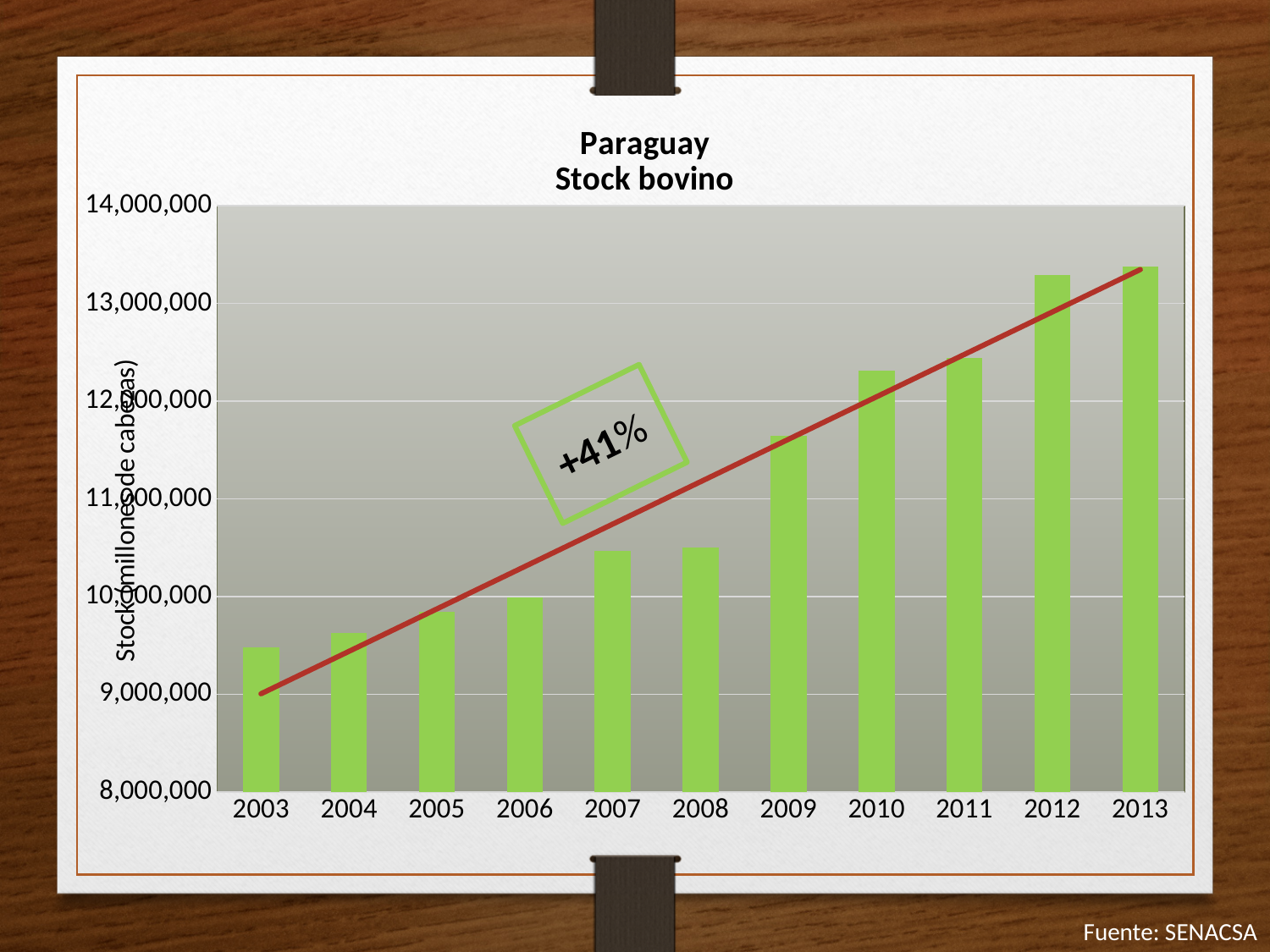
What kind of chart is shown on the slide? bar chart Is the value for 2012 greater or less than 13,000,000? greater Is the value for 2003 greater or less than 9,000,000? greater Which year has the larger value, 2007 or 2010? 2010 How many years are shown on the x axis of the chart? 11 What percentage change is written in the annotation box on the chart? +41% What is the title of the chart? Paraguay Stock bovino Is the value for 2009 greater or less than 11,000,000? greater Do the values generally rise or fall from 2003 to 2013? rise Which year has the lowest stock value? 2003